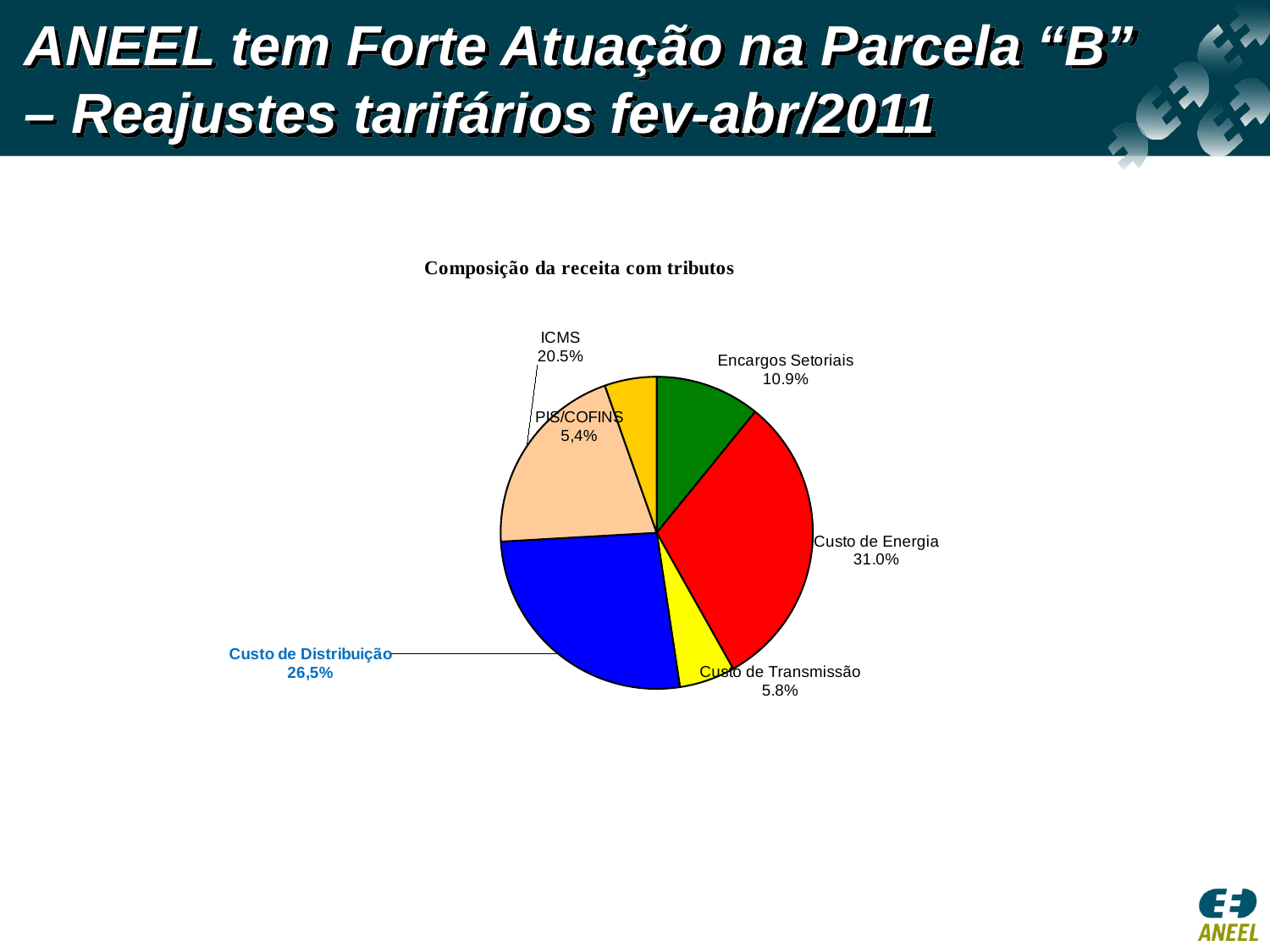
What share of the pie does Custo de Energia represent? 31.0% What is the value shown for Custo de Distribuição? 26,5% Which is larger, Custo de Energia or Custo de Distribuição? Custo de Energia What is the value shown for Encargos Setoriais? 10.9% What is the difference between the Custo de Energia share and the Encargos Setoriais share? 20.1% Which slice of the pie is the smallest? PIS/COFINS How many slices does the pie chart have? 6 What is the title of the pie chart? Composição da receita com tributos What kind of chart is shown on the slide? pie chart What is the value shown for ICMS? 20.5% What is the value shown for PIS/COFINS? 5,4% Which slice of the pie is the largest? Custo de Energia